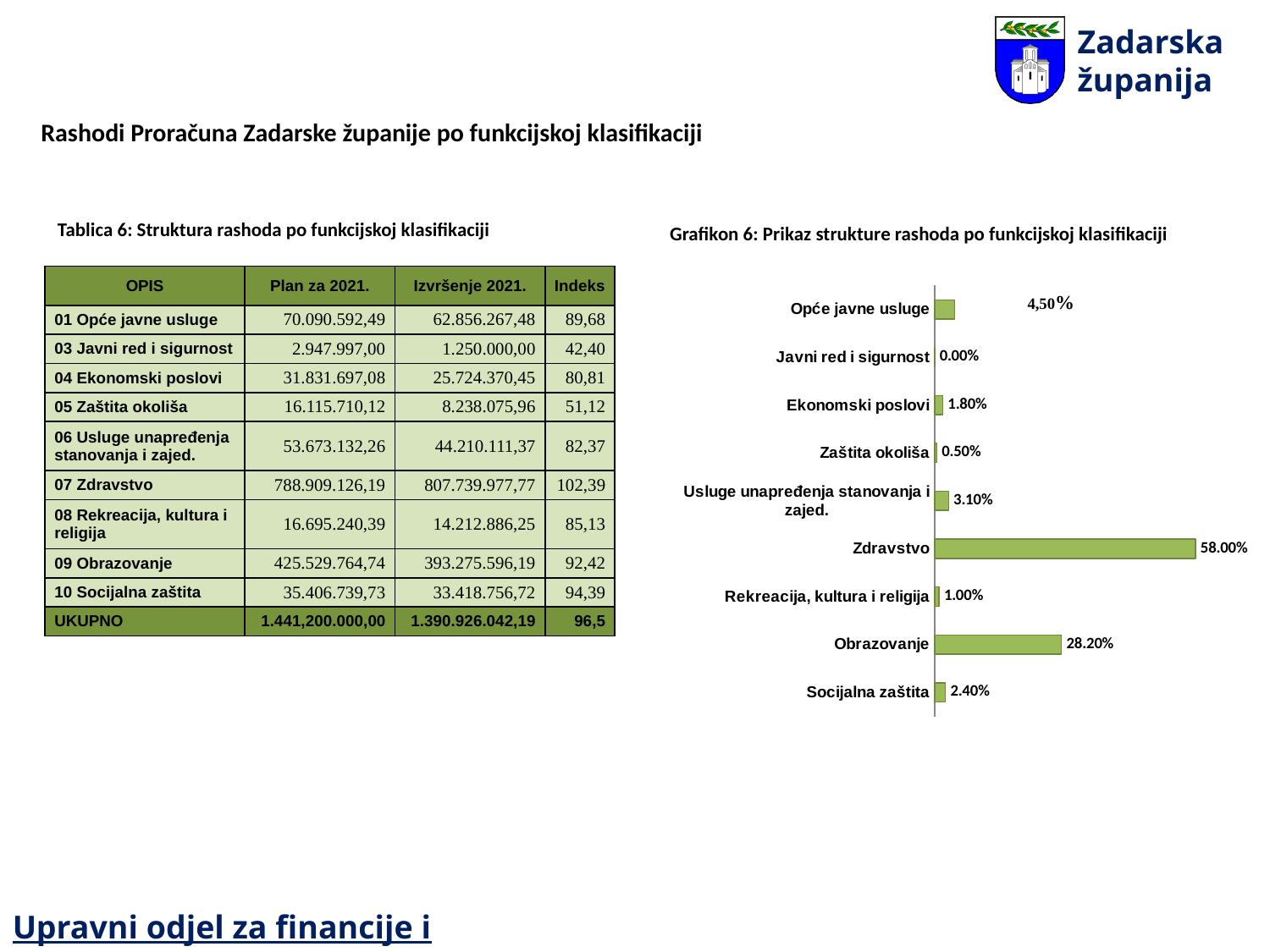
What is the value shown for Usluge unapređenja stanovanja i zajed. in the chart? 3.10% What is the value shown for Obrazovanje in the chart? 28.20% Which category has the highest value in the chart? Zdravstvo Which category has the lowest value in the chart? Javni red i sigurnost What is the title of the chart? Grafikon 6: Prikaz strukture rashoda po funkcijskoj klasifikaciji What type of chart is shown on the slide? Bar chart What is the value shown for Opće javne usluge in the chart? 4,50% What is the difference between the values for Zdravstvo and Obrazovanje? 29.80% Which is larger, the value for Ekonomski poslovi or the value for Socijalna zaštita? Socijalna zaštita What is the value shown for Zdravstvo in the chart? 58.00% How many categories are shown in the chart? 9 What is the value shown for Socijalna zaštita in the chart? 2.40%